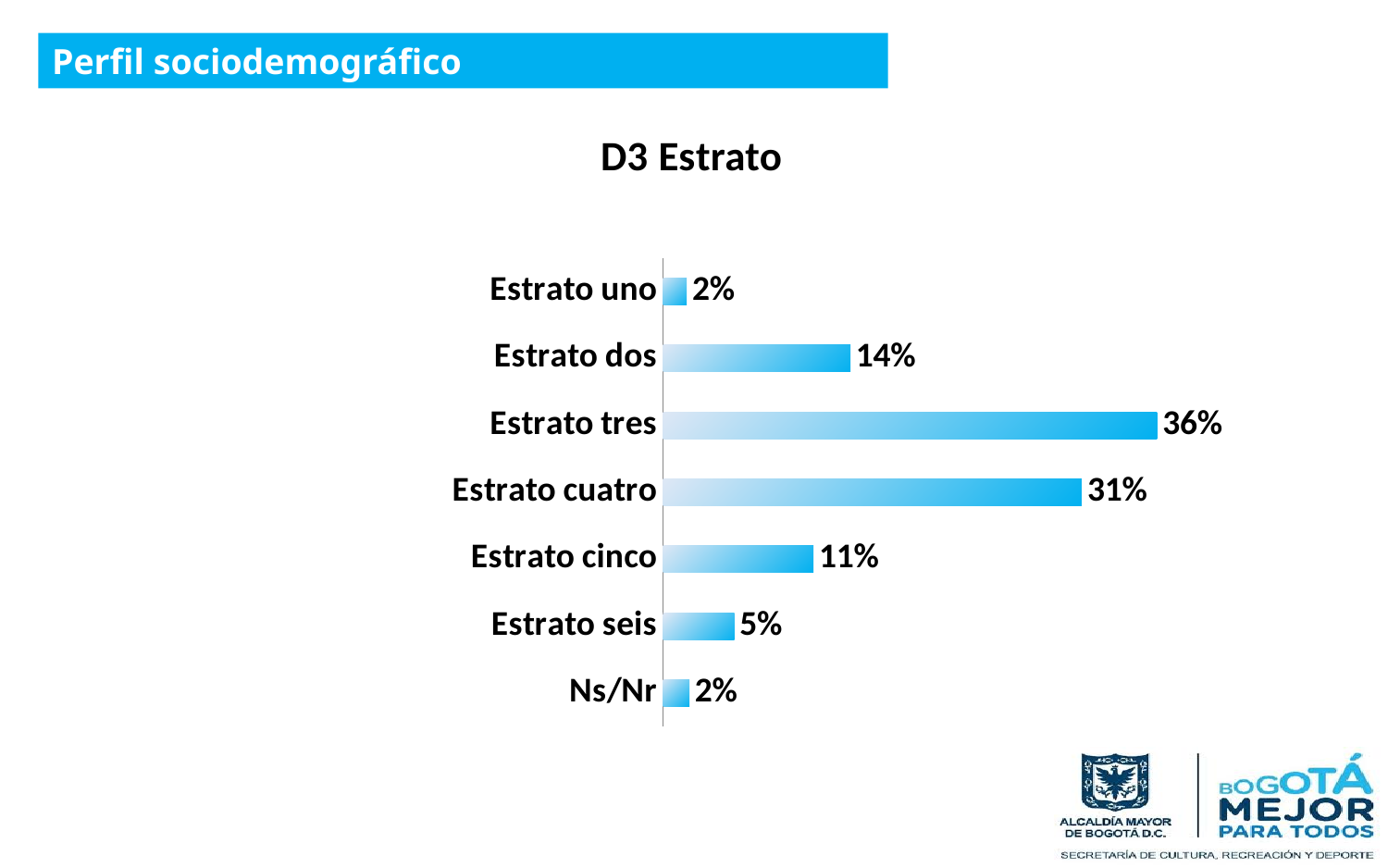
Which is larger, Estrato seis or Estrato cuatro? Estrato cuatro What is the difference between Estrato dos and Estrato cinco? 3% Which category has the highest value? Estrato tres How many categories are shown in the chart? 7 What is the value for Estrato dos? 14% What is the value for Estrato cuatro? 31% What is the value for Estrato tres? 36% What kind of chart is shown on the slide? Bar chart What is the title of the chart? D3 Estrato Which is larger, Estrato dos or Estrato cinco? Estrato dos What is the value for Estrato seis? 5% What is the difference between Estrato tres and Estrato cuatro? 5%